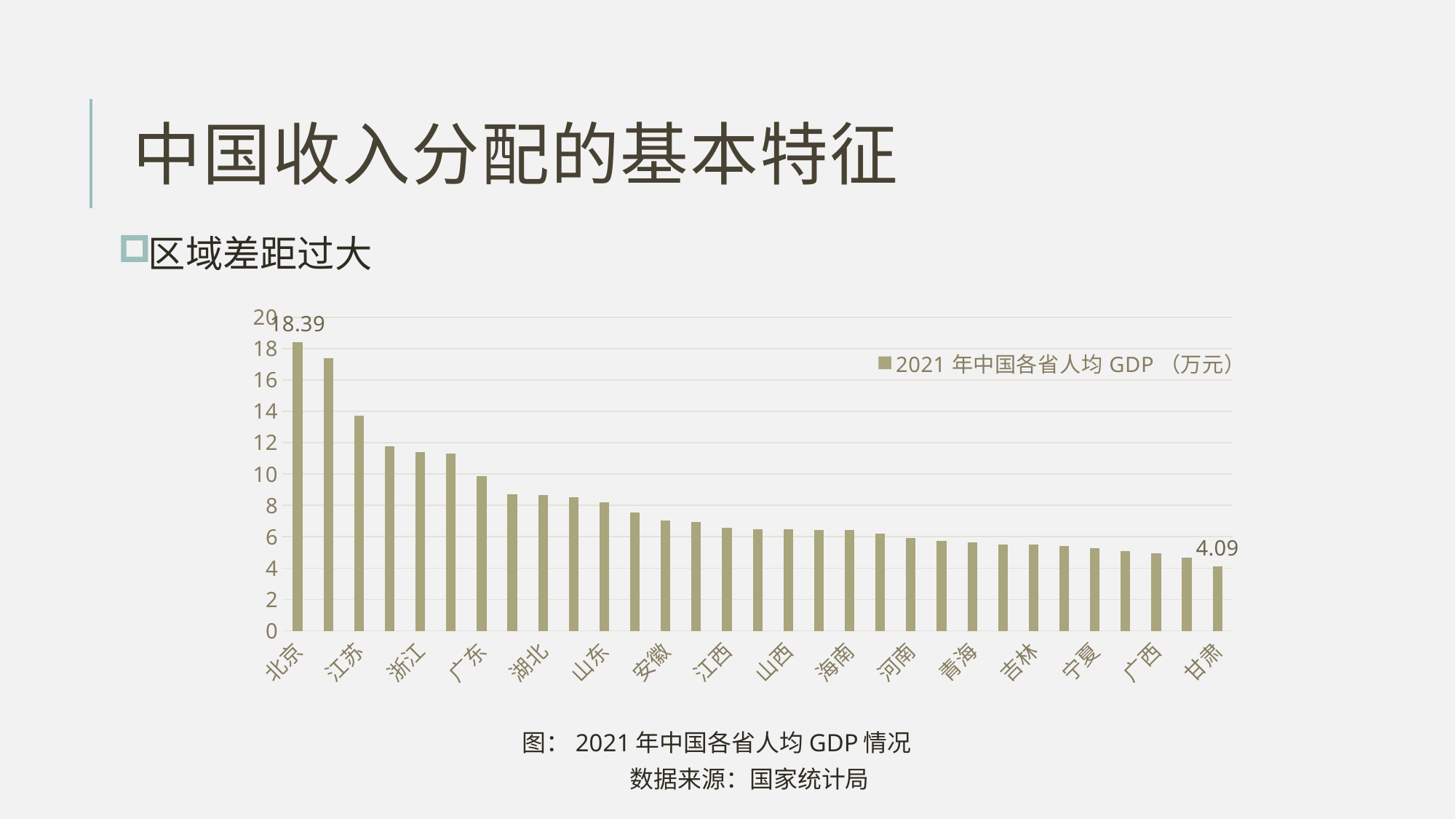
What type of chart is shown on the slide? bar chart Is the value for 广西 greater or less than 6? less Is the value for 浙江 greater or less than 10? greater Which has a larger per-capita GDP, 江苏 or 广东? 江苏 Do the values rise or fall moving from left to right along the x axis? fall Is the value for 江苏 greater or less than 12? greater What is the difference between the values for 北京 and 甘肃? 14.30 How many series does the legend list? 1 Which province has the highest per-capita GDP in the chart? 北京 Which province has the lowest per-capita GDP in the chart? 甘肃 What is the 2021 per-capita GDP value shown for 甘肃? 4.09 What is the 2021 per-capita GDP value shown for 北京? 18.39